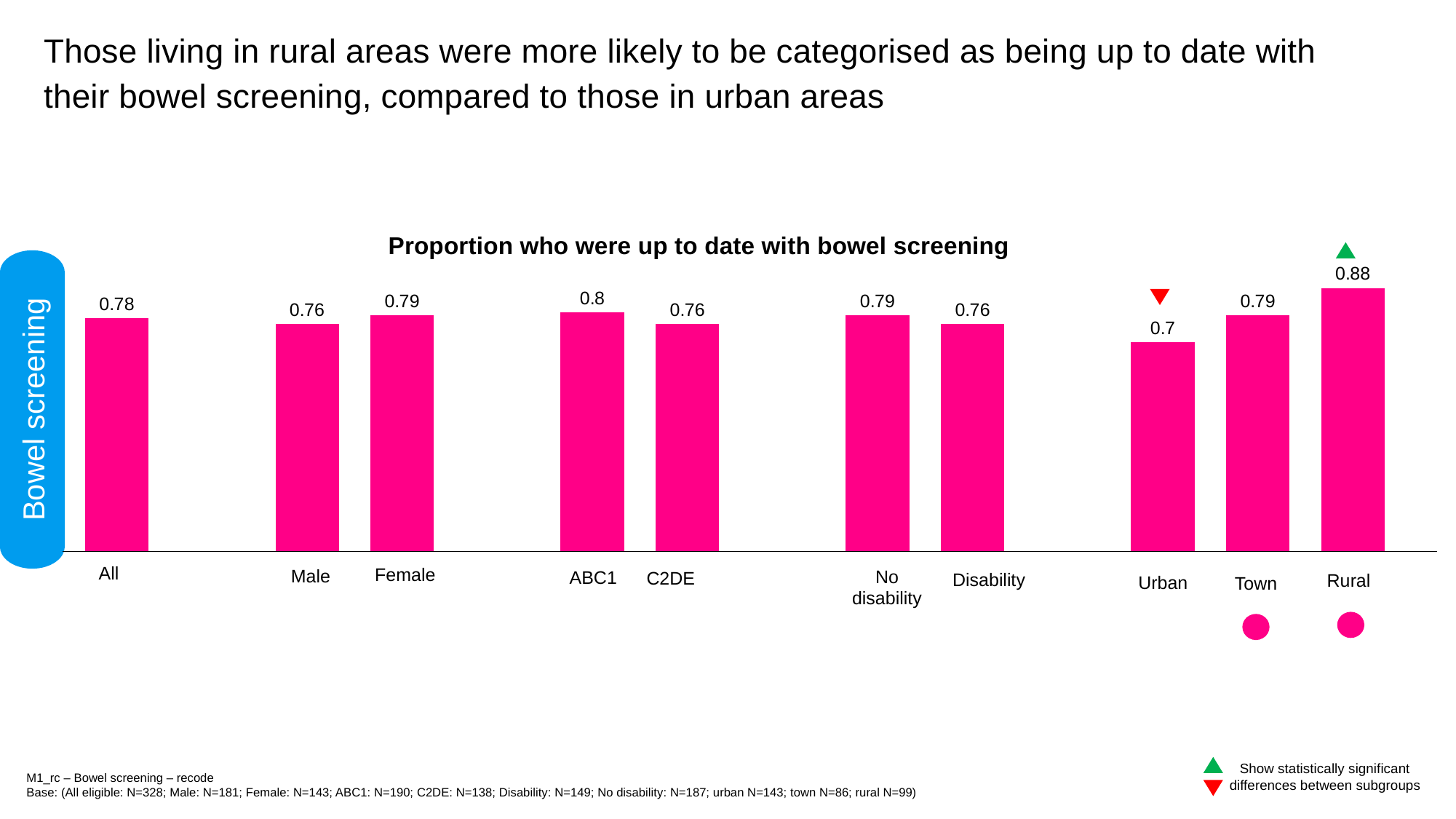
What is the value for Urban? 0.7 How many categories are shown in the chart? 10 What is the value for Rural? 0.88 What kind of chart is shown on the slide? Bar chart What is the difference between the values for Female and Male? 0.03 What is the difference between the values for Rural and Urban? 0.18 What is the title of the chart? Proportion who were up to date with bowel screening Which category has the highest value? Rural Which is larger, the value for No disability or the value for Disability? No disability Which category has the lowest value? Urban What is the value for All? 0.78 What is the value for ABC1? 0.8